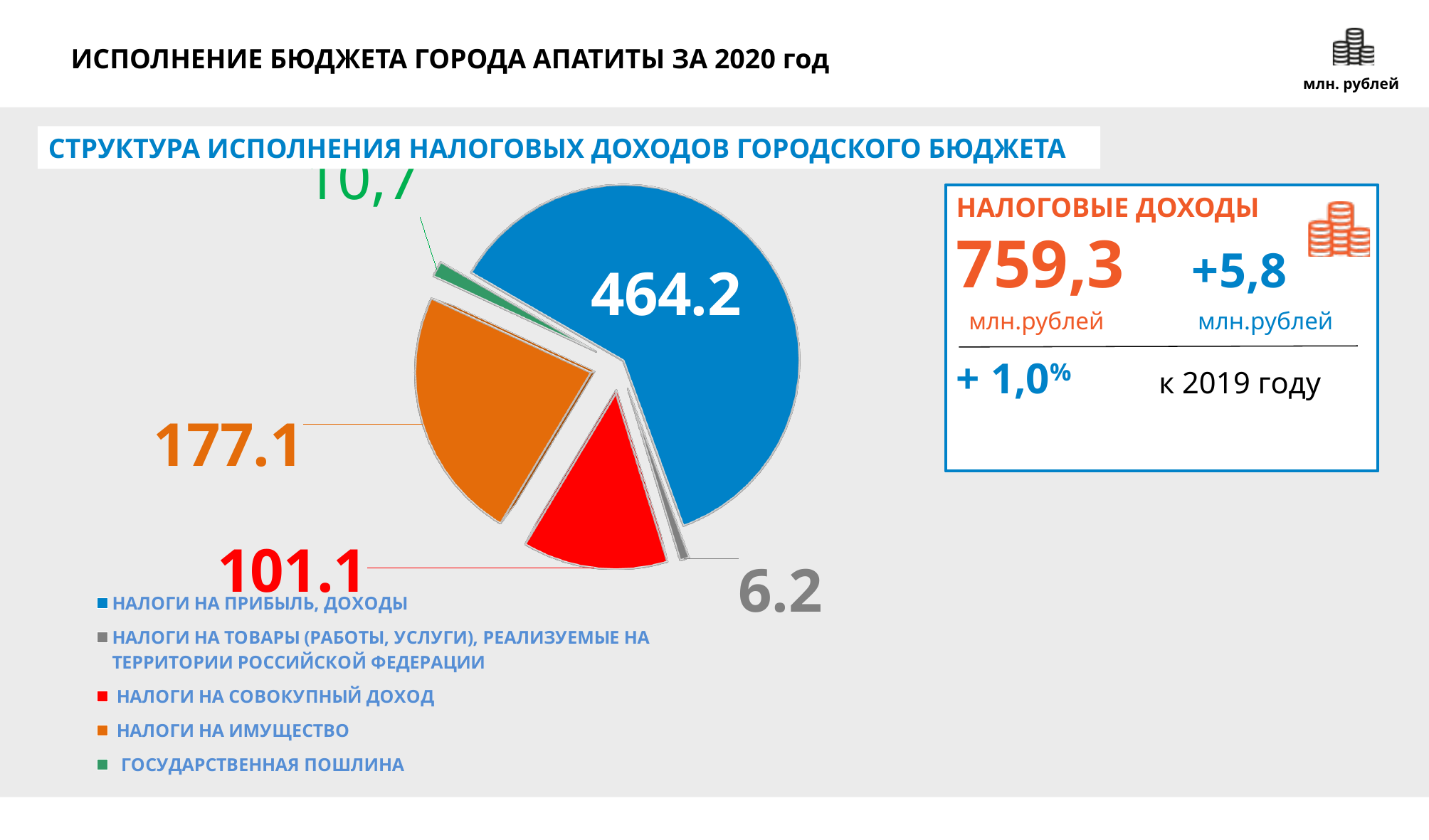
Which is larger: НАЛОГИ НА ИМУЩЕСТВО or НАЛОГИ НА СОВОКУПНЫЙ ДОХОД? НАЛОГИ НА ИМУЩЕСТВО What is the value for НАЛОГИ НА СОВОКУПНЫЙ ДОХОД in the pie chart? 101.1 What is the value for НАЛОГИ НА ТОВАРЫ (РАБОТЫ, УСЛУГИ), РЕАЛИЗУЕМЫЕ НА ТЕРРИТОРИИ РОССИЙСКОЙ ФЕДЕРАЦИИ in the pie chart? 6.2 How many categories does the pie chart have? 5 What kind of chart is shown on the slide? pie chart Which category has the smallest slice in the pie chart? НАЛОГИ НА ТОВАРЫ (РАБОТЫ, УСЛУГИ), РЕАЛИЗУЕМЫЕ НА ТЕРРИТОРИИ РОССИЙСКОЙ ФЕДЕРАЦИИ What is the difference between the values for НАЛОГИ НА ИМУЩЕСТВО and НАЛОГИ НА СОВОКУПНЫЙ ДОХОД? 76.0 What colour is the slice for НАЛОГИ НА СОВОКУПНЫЙ ДОХОД? red Which category has the largest slice in the pie chart? НАЛОГИ НА ПРИБЫЛЬ, ДОХОДЫ What is the value for НАЛОГИ НА ИМУЩЕСТВО in the pie chart? 177.1 What is the value for НАЛОГИ НА ПРИБЫЛЬ, ДОХОДЫ in the pie chart? 464.2 What is the difference between the values for НАЛОГИ НА ПРИБЫЛЬ, ДОХОДЫ and НАЛОГИ НА ИМУЩЕСТВО? 287.1